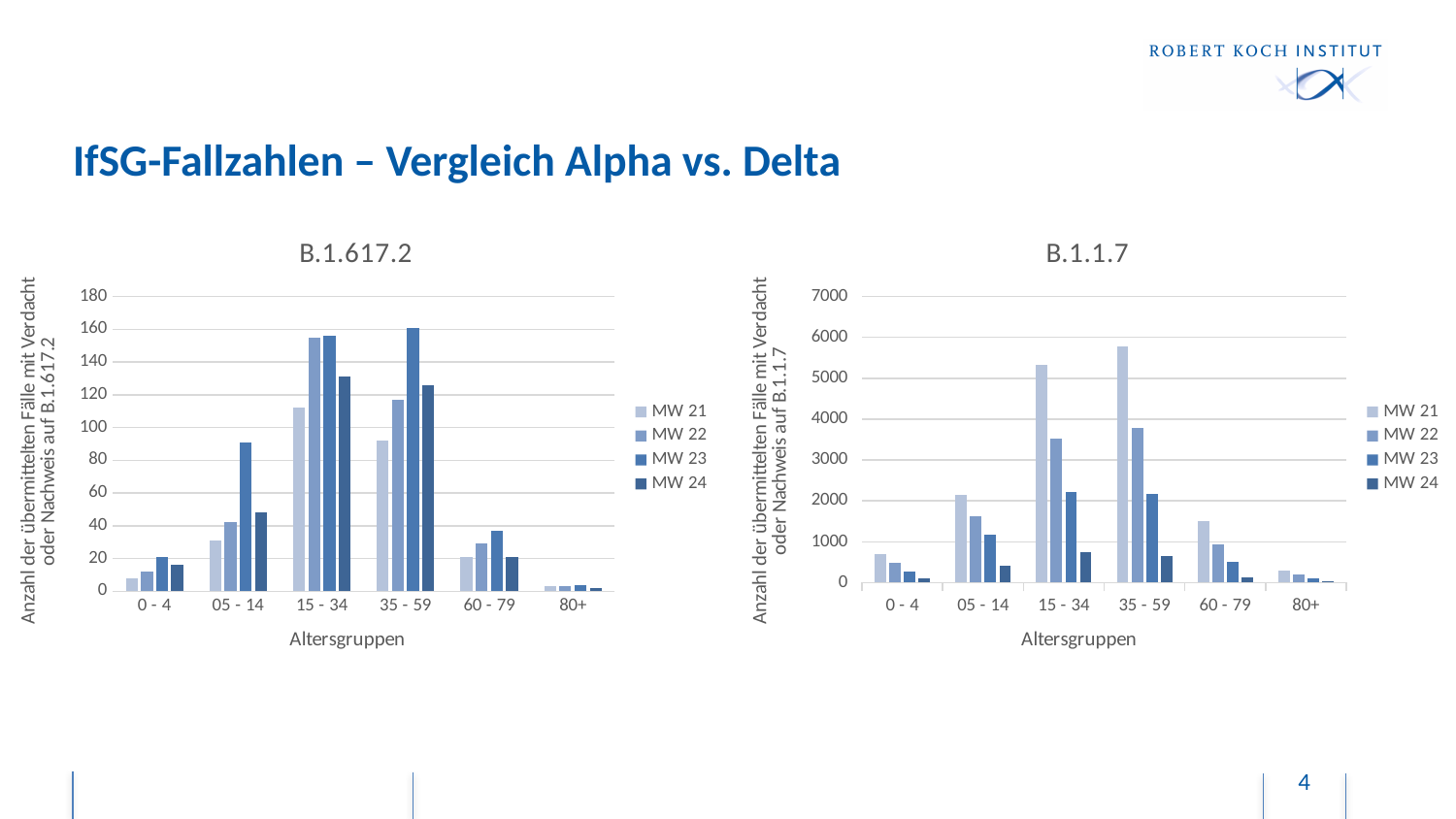
What kind of chart is the B.1.617.2 chart? bar chart How many series does the legend of the B.1.1.7 chart list? 4 In the B.1.1.7 chart, is the MW 24 value for the 35 - 59 age group greater or less than 1000? less In the B.1.617.2 chart, for the 35 - 59 age group, which is larger: MW 21 or MW 23? MW 23 What is the x-axis title of the B.1.1.7 chart? Altersgruppen In the B.1.617.2 chart, which age group has the lowest MW 23 value? 80+ In the B.1.617.2 chart, is the MW 23 value for the 05 - 14 age group greater or less than 80? greater How many age groups are shown on the x axis of the B.1.617.2 chart? 6 In the B.1.1.7 chart, is the MW 21 value for the 15 - 34 age group greater or less than 5000? greater In the B.1.1.7 chart, for the 15 - 34 age group, which is larger: MW 21 or MW 24? MW 21 In the B.1.1.7 chart, which age group has the highest MW 21 value? 35 - 59